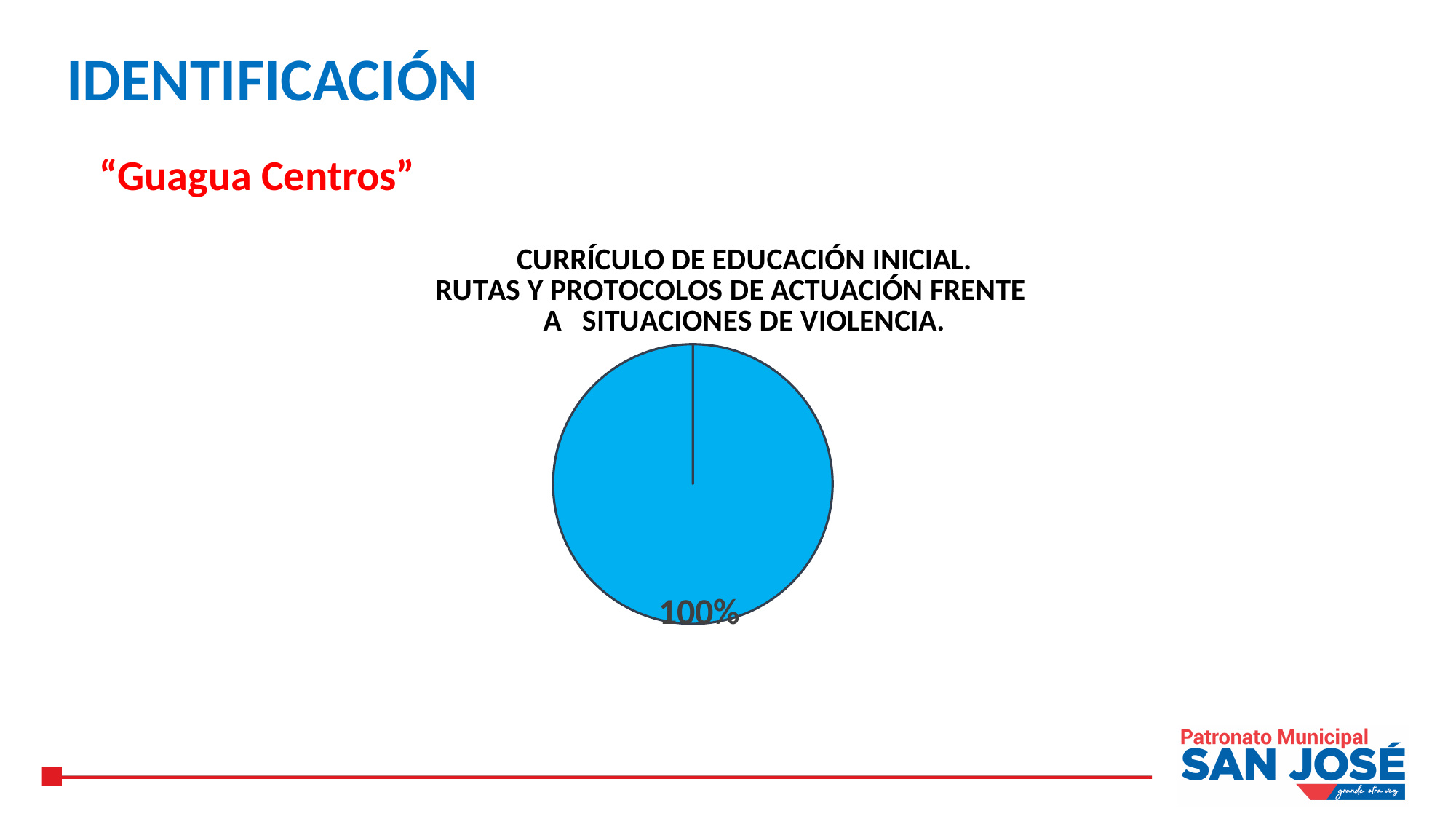
What share of the pie does the single slice represent? 100% What colour is the slice of the pie chart? blue What is the title of the pie chart? CURRÍCULO DE EDUCACIÓN INICIAL. RUTAS Y PROTOCOLOS DE ACTUACIÓN FRENTE A SITUACIONES DE VIOLENCIA. What percentage is printed on the pie chart's single slice? 100% What kind of chart is shown on the slide? pie chart How many slices does the pie chart have? 1